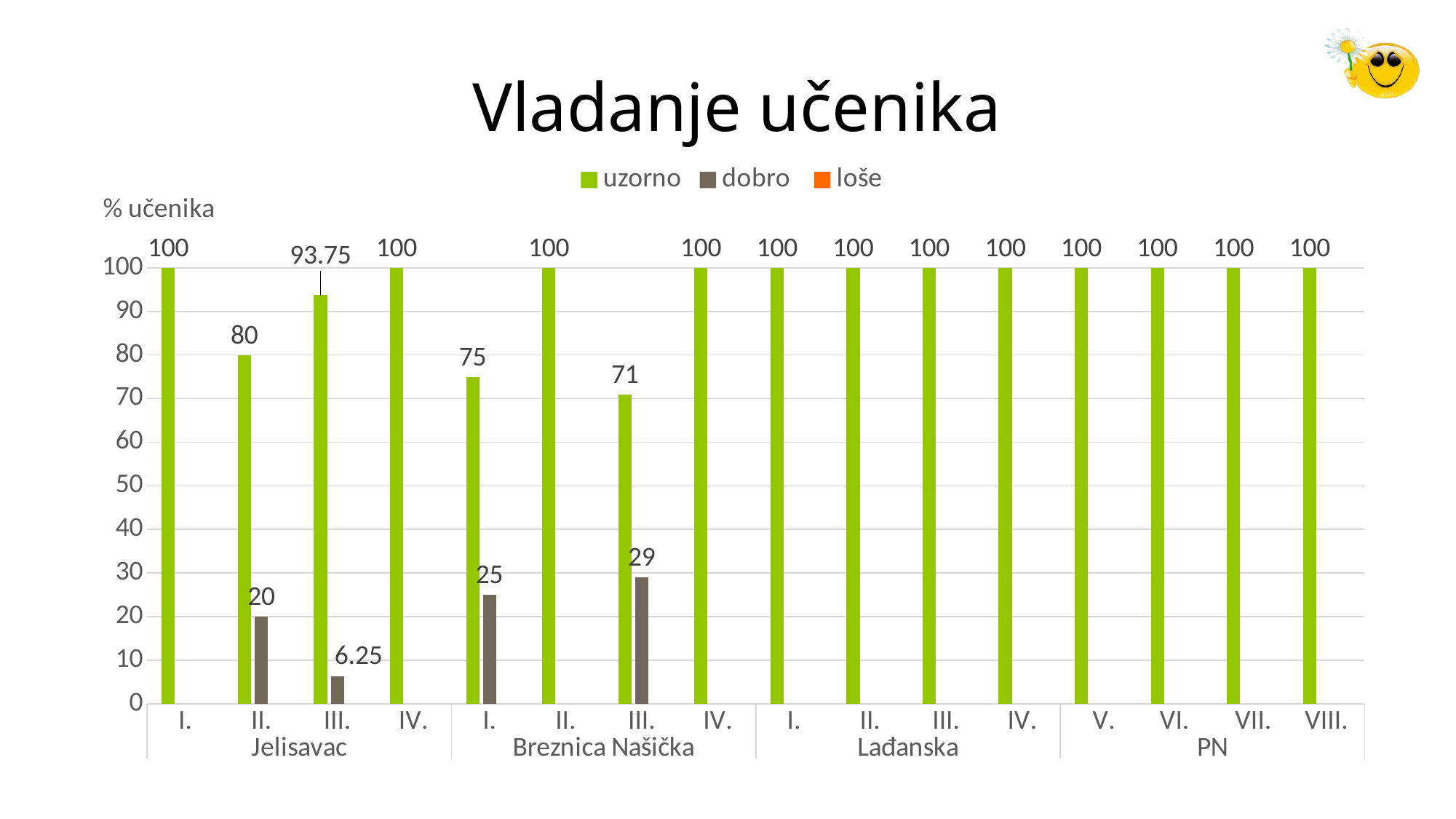
How many series does the legend list? 3 Which is larger: the 'dobro' value for class II. in Jelisavac or the 'dobro' value for class III. in Breznica Našička? class III. in Breznica Našička What is the 'uzorno' value for class II. in Jelisavac? 80 What is the total of the 'uzorno' and 'dobro' values for class I. in Breznica Našička? 100 What is the 'dobro' value for class III. in Jelisavac? 6.25 What is the title of the chart? Vladanje učenika What is the 'dobro' value for class I. in Breznica Našička? 25 What kind of chart is shown on the slide? bar chart How many classes (categories) are shown along the x axis? 16 What is the 'uzorno' value for class III. in Breznica Našička? 71 Which class in Breznica Našička has the lowest 'uzorno' value? III. What is the difference between the 'uzorno' values for class II. and class III. in Jelisavac? 13.75